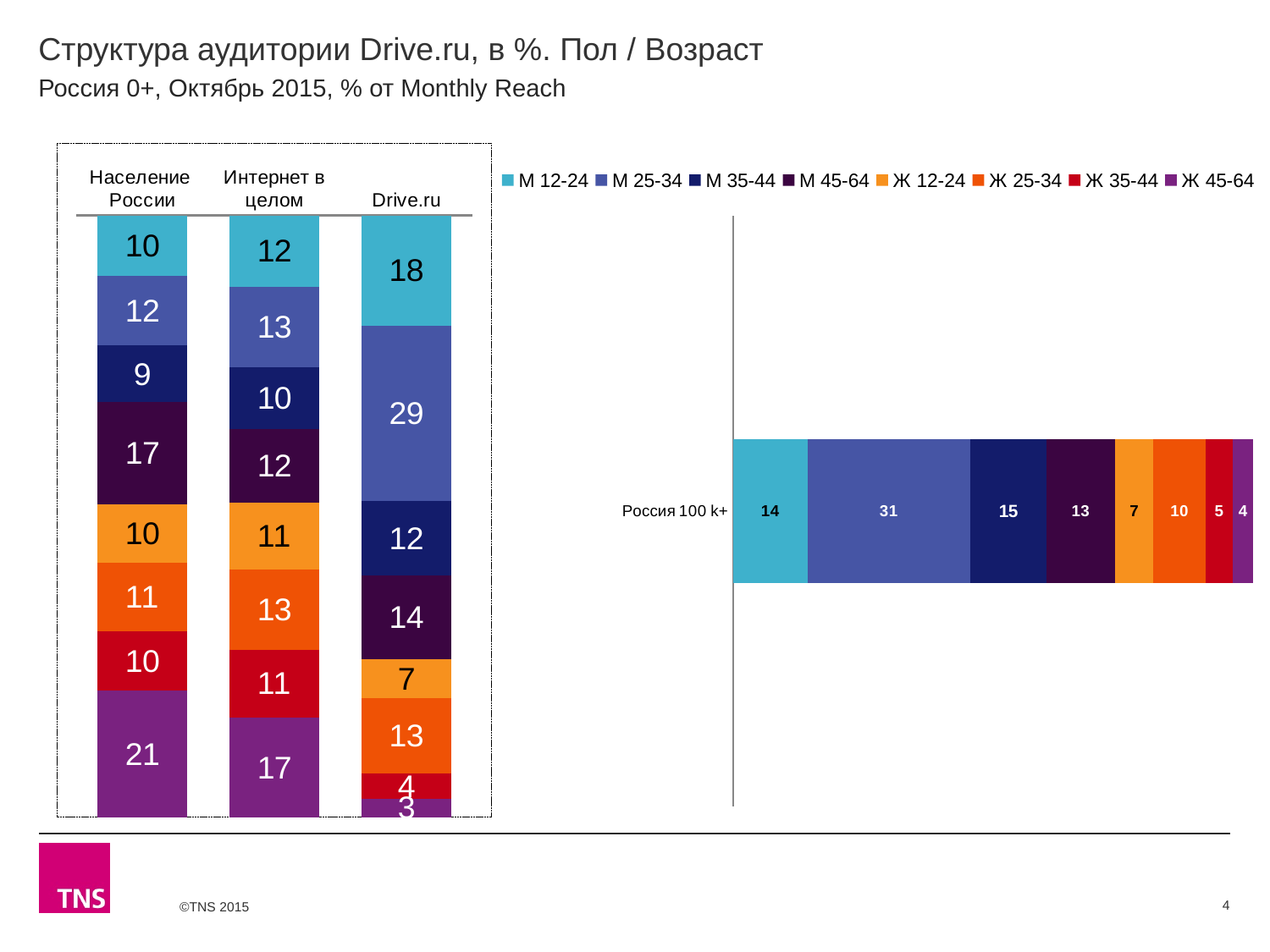
In the right chart (Россия 100 k+), what is the value for М 25-34? 31 In the left chart, what is the value for М 35-44 in the Интернет в целом column? 10 In the right chart (Россия 100 k+), which segment has the largest value? М 25-34 In the left chart, what is the difference between the М 25-34 values for Drive.ru and Население России? 17 How many columns (categories) are shown in the left chart? 3 What type of chart is the right chart (Россия 100 k+)? Stacked bar chart In the left chart, which is larger: Ж 45-64 for Население России or Ж 45-64 for Drive.ru? Население России In the left chart, what is the value for Ж 45-64 in the Население России column? 21 In the left chart, which segment of the Drive.ru column is the smallest? Ж 45-64 In the left chart, what is the value for М 25-34 in the Drive.ru column? 29 How many series does the legend list? 8 In the right chart (Россия 100 k+), what is the total of all segments in the bar? 99